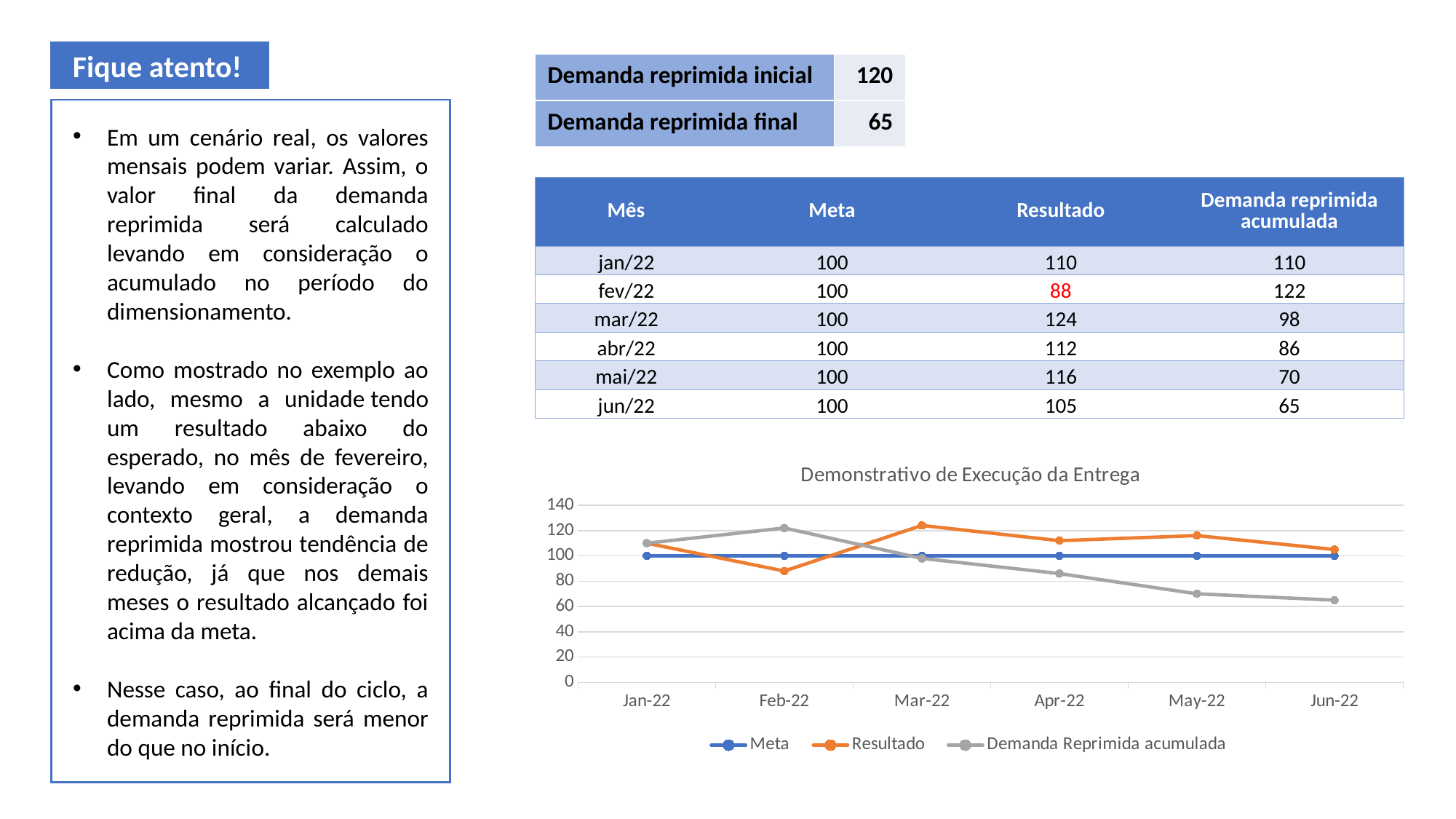
What is the title of the chart? Demonstrativo de Execução da Entrega How many series does the legend of the chart list? 3 In which month is the Resultado series at its lowest? Feb-22 In which month is the Resultado series at its highest? Mar-22 Is the Resultado value for Feb-22 greater or less than 100? less What type of chart is 'Demonstrativo de Execução da Entrega'? line chart How many months are plotted on the x axis of the chart? 6 Which series in the chart is drawn in orange? Resultado What is the value of the Meta series in every month of the chart? 100 In Mar-22, which is larger: Resultado or Demanda Reprimida acumulada? Resultado Is the Demanda Reprimida acumulada value for Jun-22 greater or less than 80? less Does the Demanda Reprimida acumulada series rise or fall from Feb-22 to Jun-22? fall